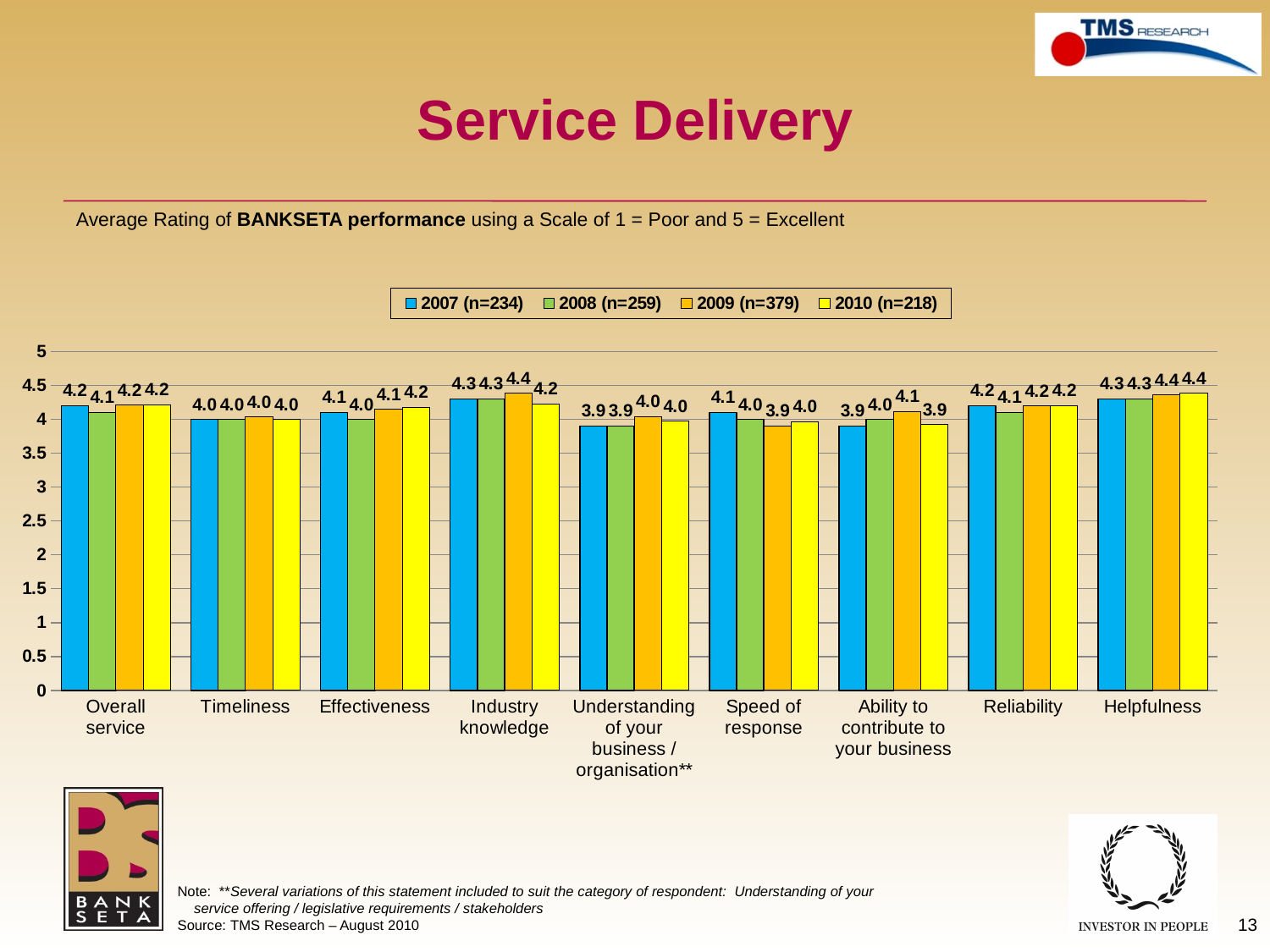
Which category has the highest 2010 rating? Helpfulness Which category has the lowest 2009 rating? Speed of response Is the 2007 value for Timeliness greater or less than 3.5? greater What is the 2010 rating for Helpfulness? 4.4 What kind of chart is shown on the slide? Bar chart How many series does the legend list? 4 What is the 2009 rating for Ability to contribute to your business? 4.1 What is the 2007 rating for Speed of response? 4.1 For Effectiveness, which is larger: the 2008 rating or the 2010 rating? 2010 What is the difference between the 2009 and 2010 ratings for Industry knowledge? 0.2 How many categories are shown on the x axis? 9 Which category has the lowest 2010 rating? Ability to contribute to your business